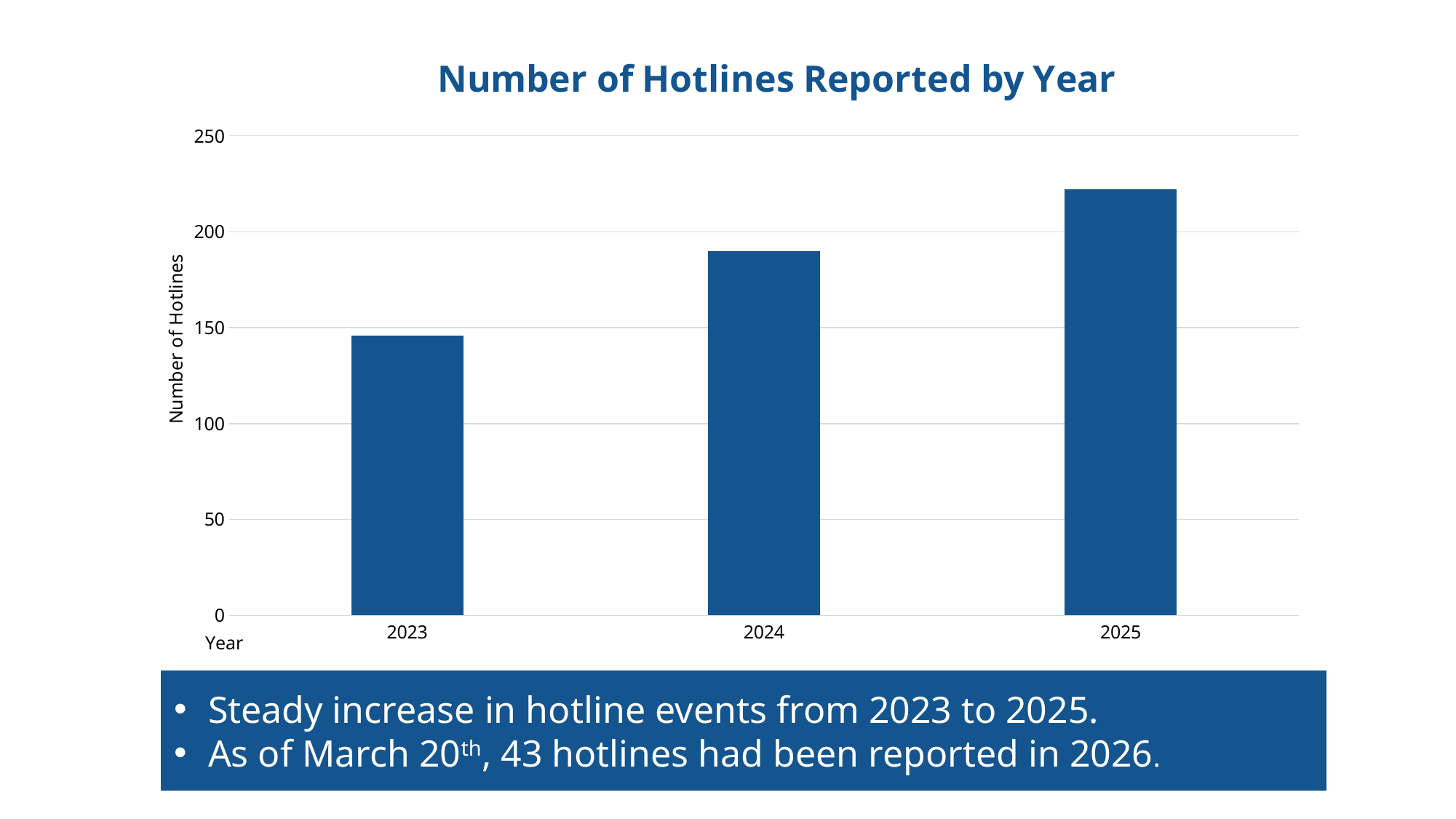
Is the number of hotlines reported in 2024 greater or less than 200? less Which year has more hotlines reported, 2024 or 2025? 2025 Which year has the highest number of hotlines reported? 2025 What is the title of the chart? Number of Hotlines Reported by Year Is the number of hotlines reported in 2023 greater or less than 100? greater What is the label of the vertical axis of the chart? Number of Hotlines What kind of chart is shown on the slide? bar chart Which year has the lowest number of hotlines reported? 2023 Is the number of hotlines reported in 2025 greater or less than 200? greater How many years are shown on the x axis of the chart? 3 Which year has more hotlines reported, 2023 or 2024? 2024 Do the number of hotlines reported rise or fall from 2023 to 2025? rise